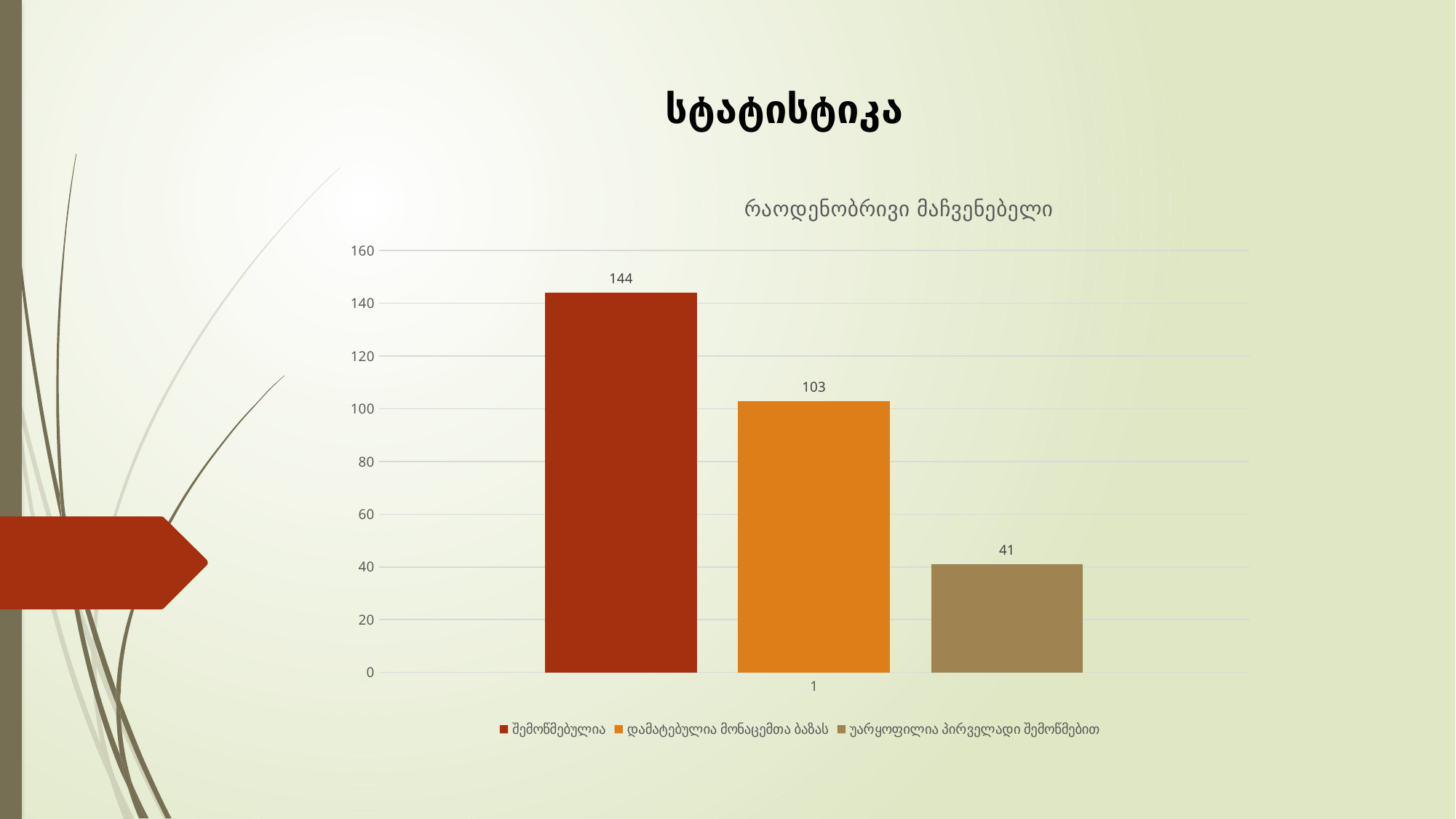
Is the value for შემოწმებულია greater or less than 140? greater Which series has the lowest value? უარყოფილია პირველადი შემოწმებით What is the difference between the values for დამატებულია მონაცემთა ბაზას and უარყოფილია პირველადი შემოწმებით? 62 What is the value for დამატებულია მონაცემთა ბაზას? 103 Which is larger, the value for დამატებულია მონაცემთა ბაზას or the value for უარყოფილია პირველადი შემოწმებით? დამატებულია მონაცემთა ბაზას Which series has the highest value? შემოწმებულია How many series does the legend list? 3 What is the value for უარყოფილია პირველადი შემოწმებით? 41 What kind of chart is shown on the slide? bar chart What is the value for შემოწმებულია? 144 What is the difference between the values for შემოწმებულია and დამატებულია მონაცემთა ბაზას? 41 What is the title of the chart? რაოდენობრივი მაჩვენებელი